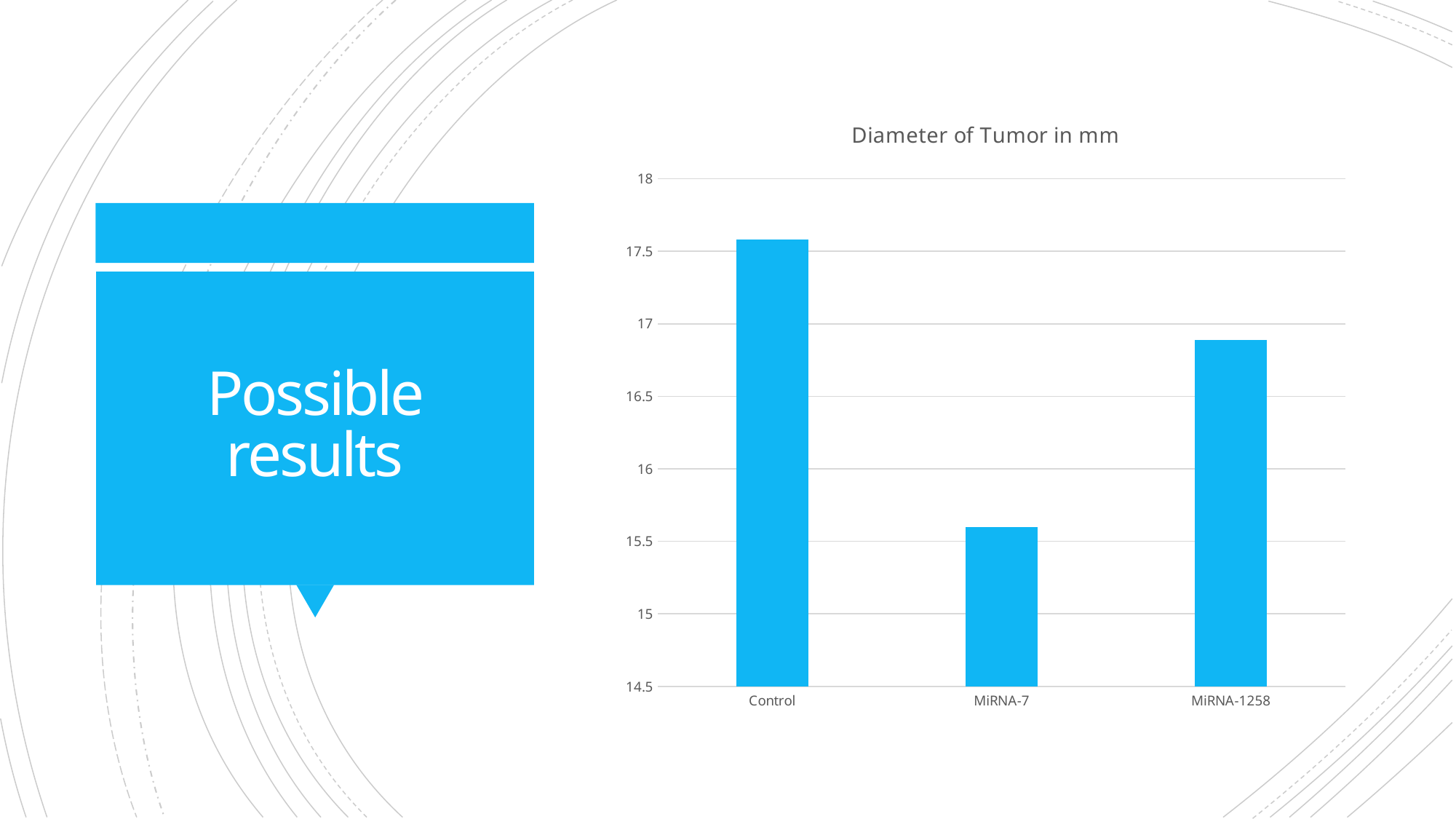
What is the title of the chart? Diameter of Tumor in mm Is the value for Control greater or less than 17? greater What kind of chart is shown on the slide? bar chart Which category has the smallest tumor diameter? MiRNA-7 Is the value for MiRNA-7 greater or less than 16? less Which category has the largest tumor diameter? Control What is the lowest value shown on the vertical axis? 14.5 How many categories are plotted in the chart? 3 Which has a larger value, MiRNA-7 or MiRNA-1258? MiRNA-1258 Is the value for MiRNA-1258 greater or less than 16.5? greater Which has a larger value, Control or MiRNA-1258? Control